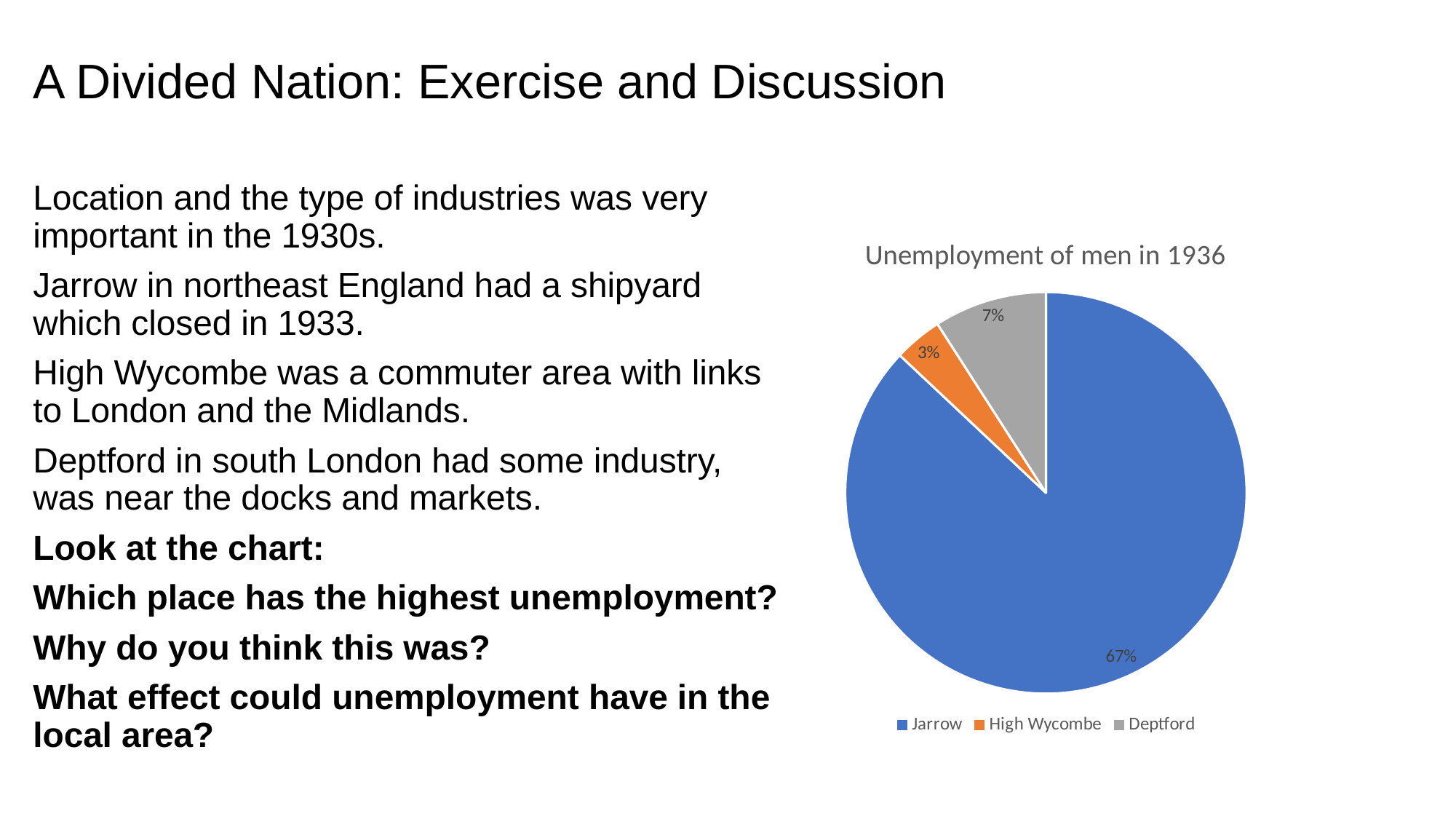
What value is shown for Jarrow in the chart? 67% Which has the larger value, Deptford or High Wycombe? Deptford What type of chart is shown on the slide? Pie chart What is the difference between the values for Jarrow and Deptford? 60% What is the difference between the values for Deptford and High Wycombe? 4% What value is shown for High Wycombe in the chart? 3% How many entries does the legend list? 3 How many places are shown in the chart? 3 What value is shown for Deptford in the chart? 7% Which place has the lowest value in the chart? High Wycombe What is the title of the chart? Unemployment of men in 1936 Which place has the highest value in the chart? Jarrow